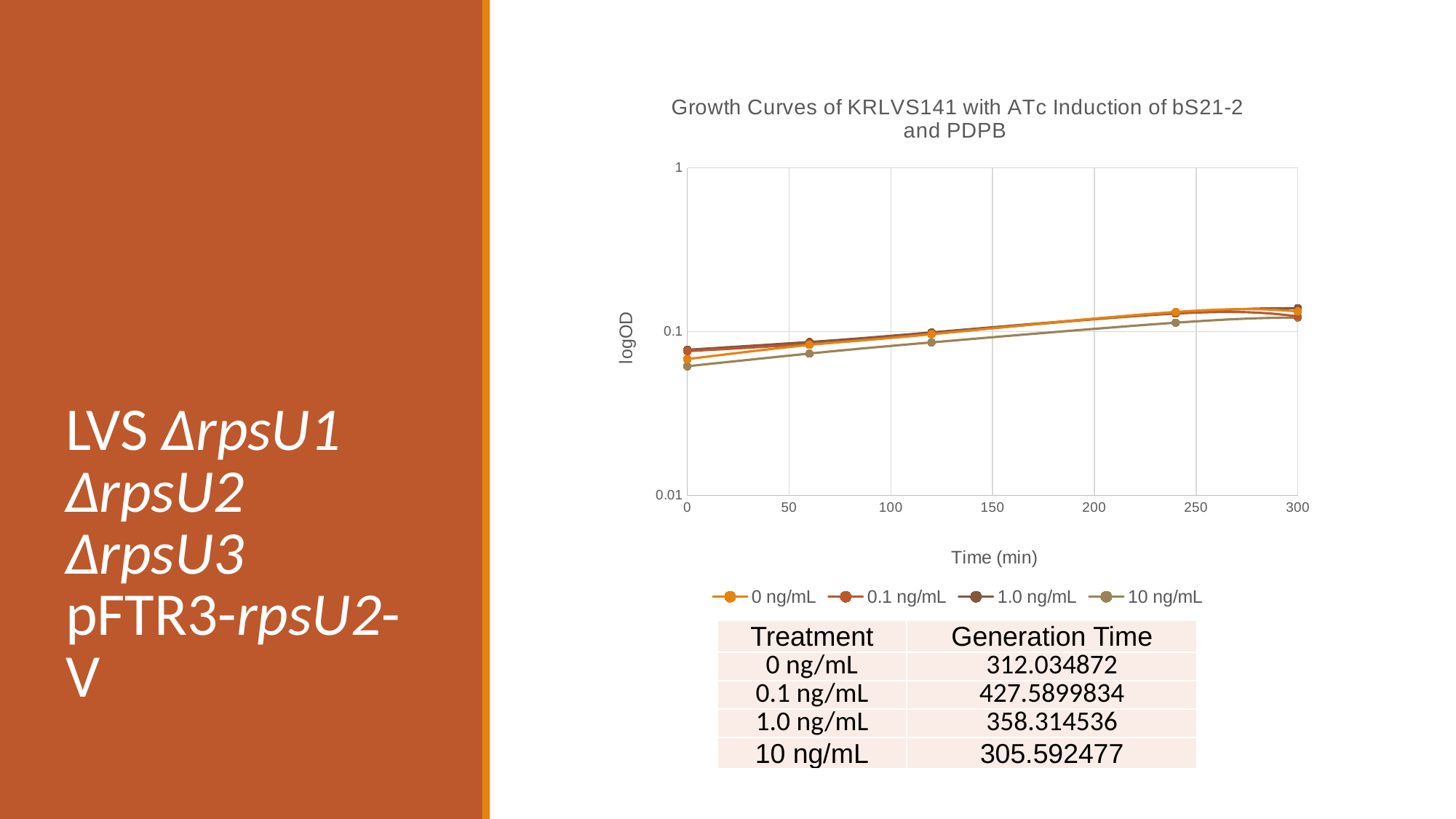
How many series does the chart legend list? 4 What kind of chart is shown on the slide? line chart Which series has the lowest logOD value at time 0? 10 ng/mL Is the logOD value for the 10 ng/mL series at 120 min greater or less than 0.1? less Is the logOD value for the 10 ng/mL series at time 0 greater or less than 0.1? less Is the logOD value for the 0 ng/mL series at 300 min greater or less than 0.1? greater How many time points are plotted for each series in the chart? 5 Do the logOD values for the 0 ng/mL series rise or fall as time increases? rise At 120 min, which series has the higher logOD value, 1.0 ng/mL or 10 ng/mL? 1.0 ng/mL What is the label of the x axis of the chart? Time (min) What is the title of the chart? Growth Curves of KRLVS141 with ATc Induction of bS21-2 and PDPB